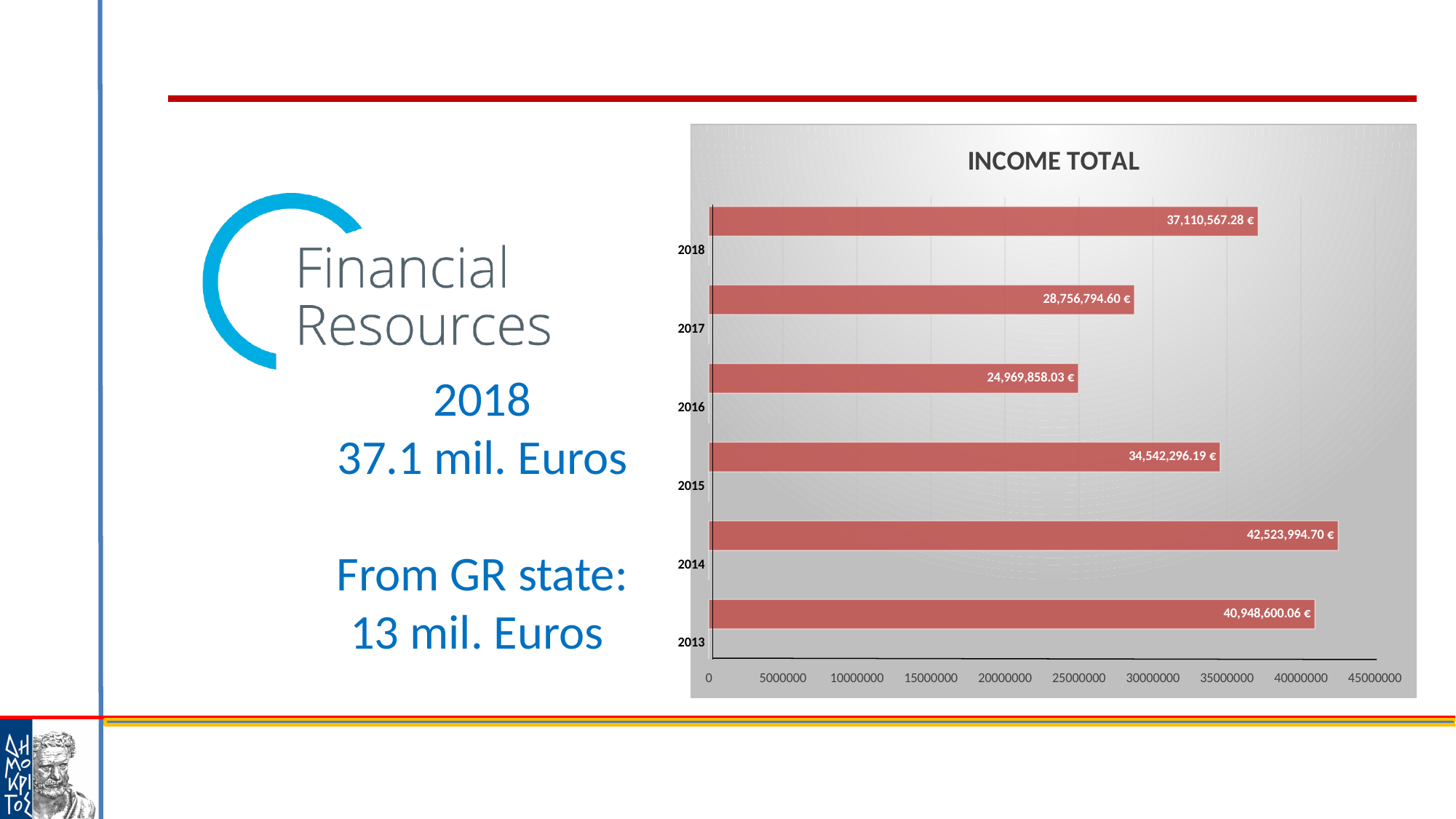
What is the INCOME TOTAL value for 2016? 24,969,858.03 € Which year has a larger INCOME TOTAL, 2015 or 2017? 2015 What is the INCOME TOTAL value for 2018? 37,110,567.28 € Which year has the lowest INCOME TOTAL? 2016 How many years are shown in the INCOME TOTAL chart? 6 What kind of chart is used to show INCOME TOTAL? Bar chart What is the difference between the INCOME TOTAL for 2014 and 2013? 1,575,394.64 € What is the INCOME TOTAL value for 2013? 40,948,600.06 € Is the INCOME TOTAL for 2017 greater or less than 30000000? less What is the difference between the INCOME TOTAL for 2018 and 2017? 8,353,772.68 € Which year has the highest INCOME TOTAL? 2014 What is the title of the chart on the slide? INCOME TOTAL